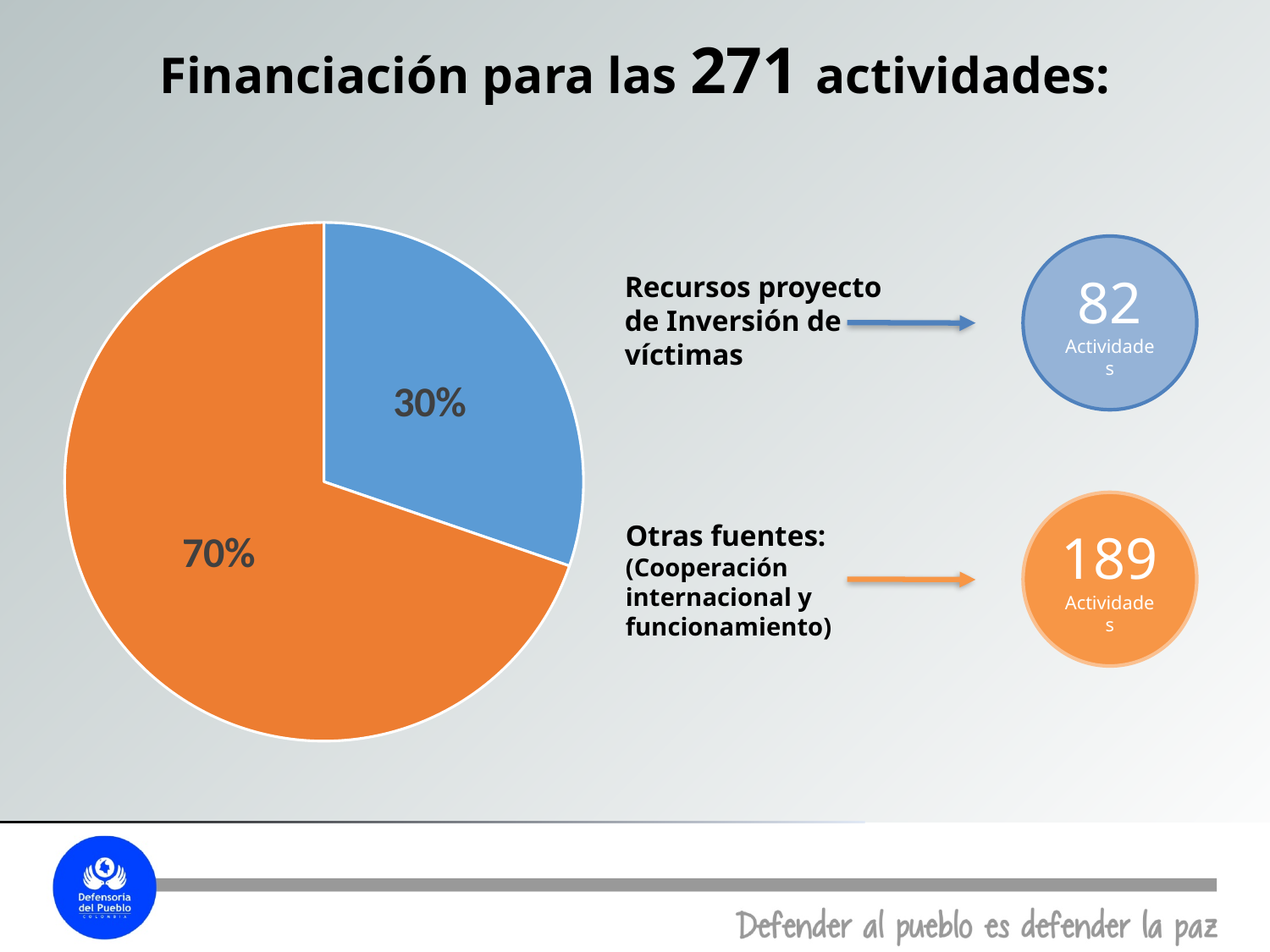
What share of the pie corresponds to 'Otras fuentes' (the orange slice)? 70% What colour is the slice representing 'Otras fuentes' in the pie chart? orange Which slice of the pie chart is the largest? 70% (Otras fuentes, orange) What kind of chart is shown on the slide? pie chart How many activities are attributed to 'Recursos proyecto de Inversión de víctimas' according to the slide? 82 What percentage is shown on the blue slice of the pie chart? 30% What percentage is shown on the orange slice of the pie chart? 70% How many slices does the pie chart have? 2 Which slice of the pie chart is the smallest? 30% (Recursos proyecto de Inversión de víctimas, blue) What is the difference in percentage points between the orange slice and the blue slice? 40 percentage points Which is larger: the share for 'Otras fuentes' or the share for 'Recursos proyecto de Inversión de víctimas'? Otras fuentes What share of the pie corresponds to 'Recursos proyecto de Inversión de víctimas' (the blue slice)? 30%